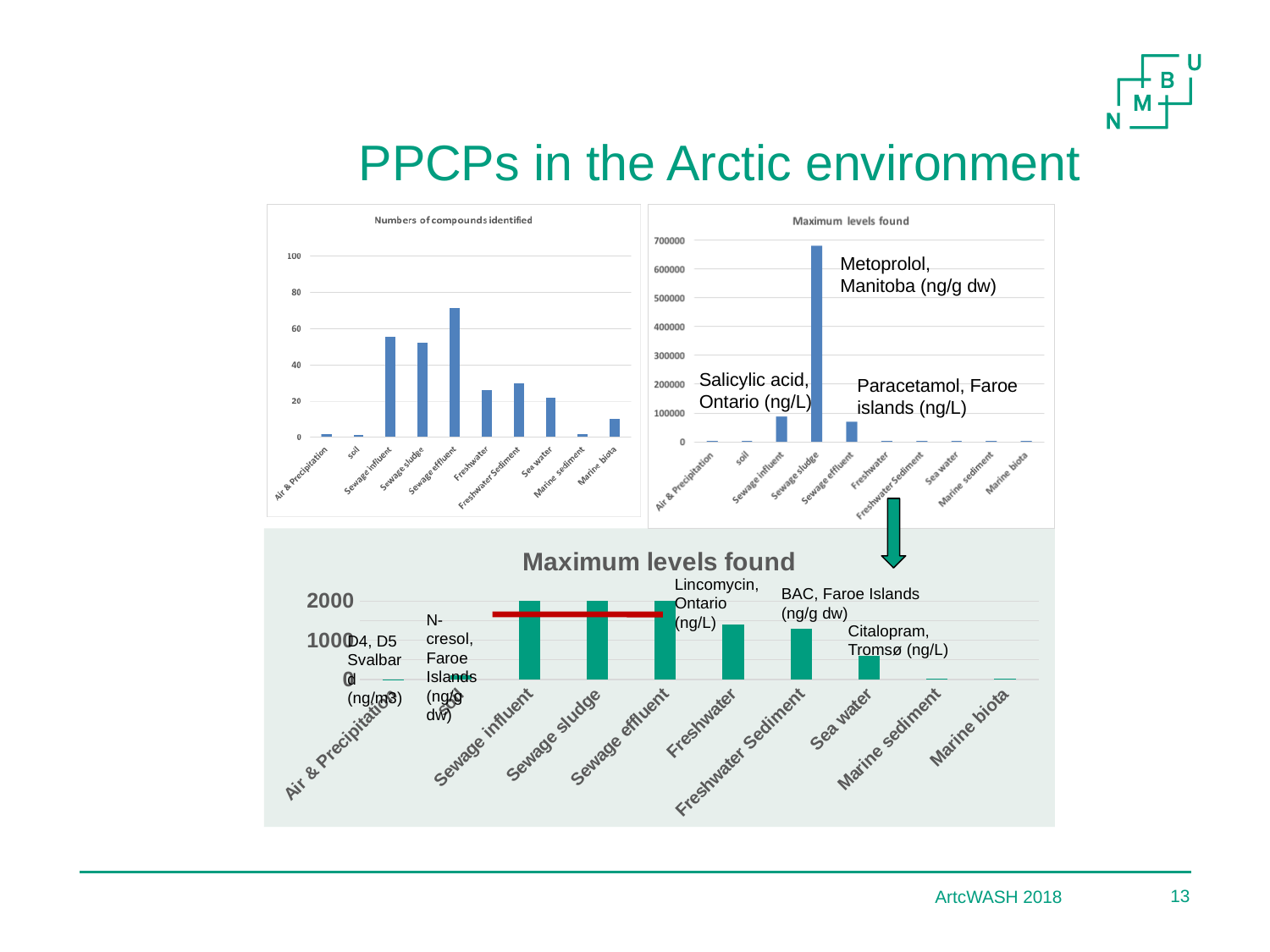
In the top-right chart 'Maximum levels found', which category has the highest value? Sewage sludge What kind of chart is the top-left chart titled 'Numbers of compounds identified'? bar chart In the top-right chart 'Maximum levels found', which is larger: the value for Sewage influent or the value for Sewage effluent? Sewage influent In the bottom chart 'Maximum levels found', is the value for Sea water greater or less than 1000? less In the top-left chart 'Numbers of compounds identified', which is larger: the value for Sewage influent or the value for Freshwater? Sewage influent How many categories are shown on the x axis of the top-left chart 'Numbers of compounds identified'? 10 In the top-left chart 'Numbers of compounds identified', is the value for Sewage effluent greater or less than 60? greater In the top-left chart 'Numbers of compounds identified', is the value for Freshwater greater or less than 40? less In the top-right chart 'Maximum levels found', which compound and location is annotated next to the tallest bar? Metoprolol, Manitoba (ng/g dw) In the top-left chart 'Numbers of compounds identified', which category has the highest value? Sewage effluent